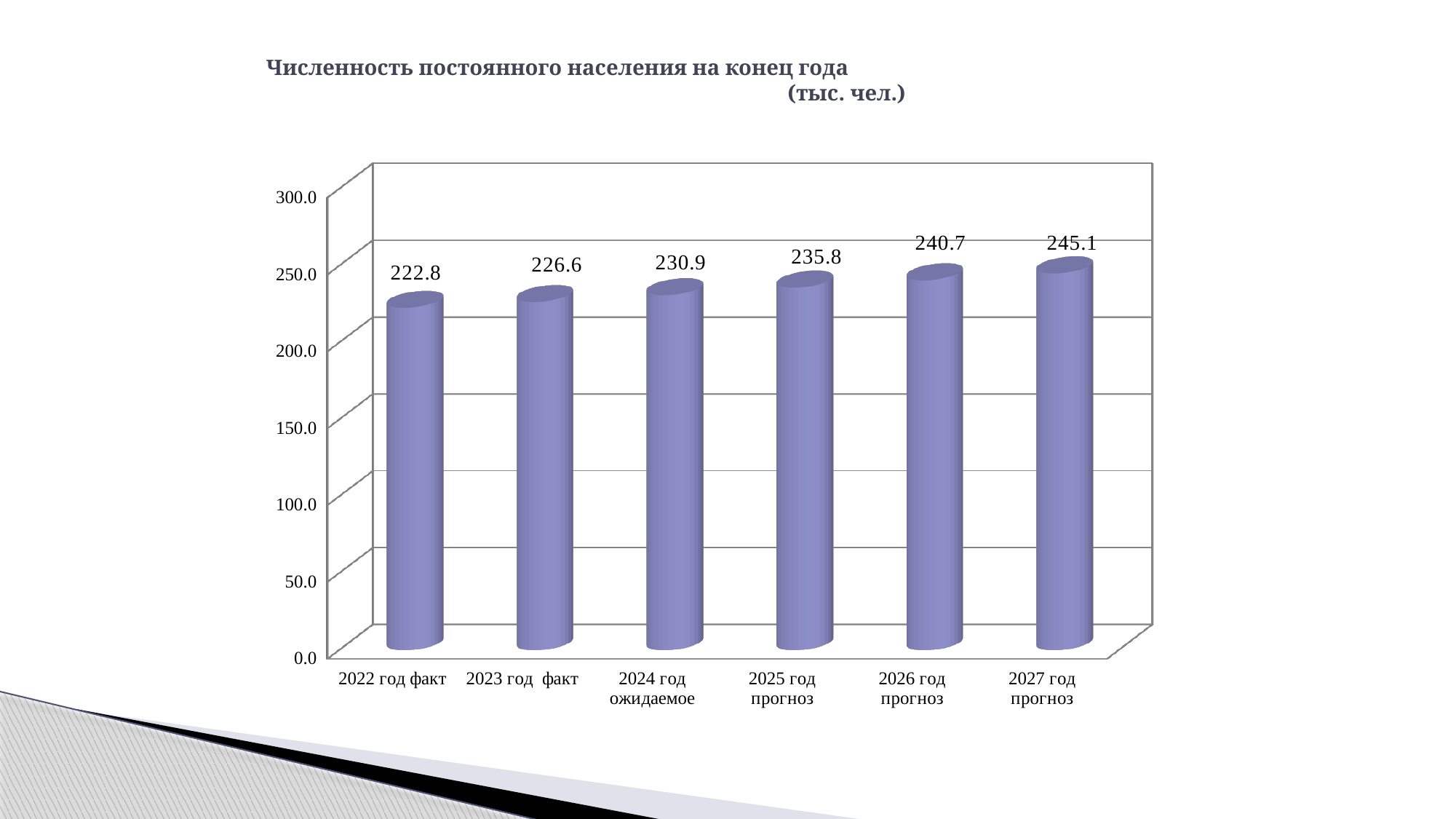
Which is larger, the value for 2026 год прогноз or the value for 2024 год ожидаемое? 2026 год прогноз What is the value for 2025 год прогноз? 235.8 What kind of chart is shown on the slide? bar chart How many categories are shown on the x axis? 6 What is the difference between the values for 2027 год прогноз and 2022 год факт? 22.3 What is the value for 2027 год прогноз? 245.1 Is the value for 2023 год факт greater or less than 200.0? greater Do the values rise or fall from 2022 to 2027 along the x axis? rise What is the value for 2022 год факт? 222.8 Which category has the lowest value? 2022 год факт What is the difference between the values for 2024 год ожидаемое and 2023 год факт? 4.3 Which category has the highest value? 2027 год прогноз